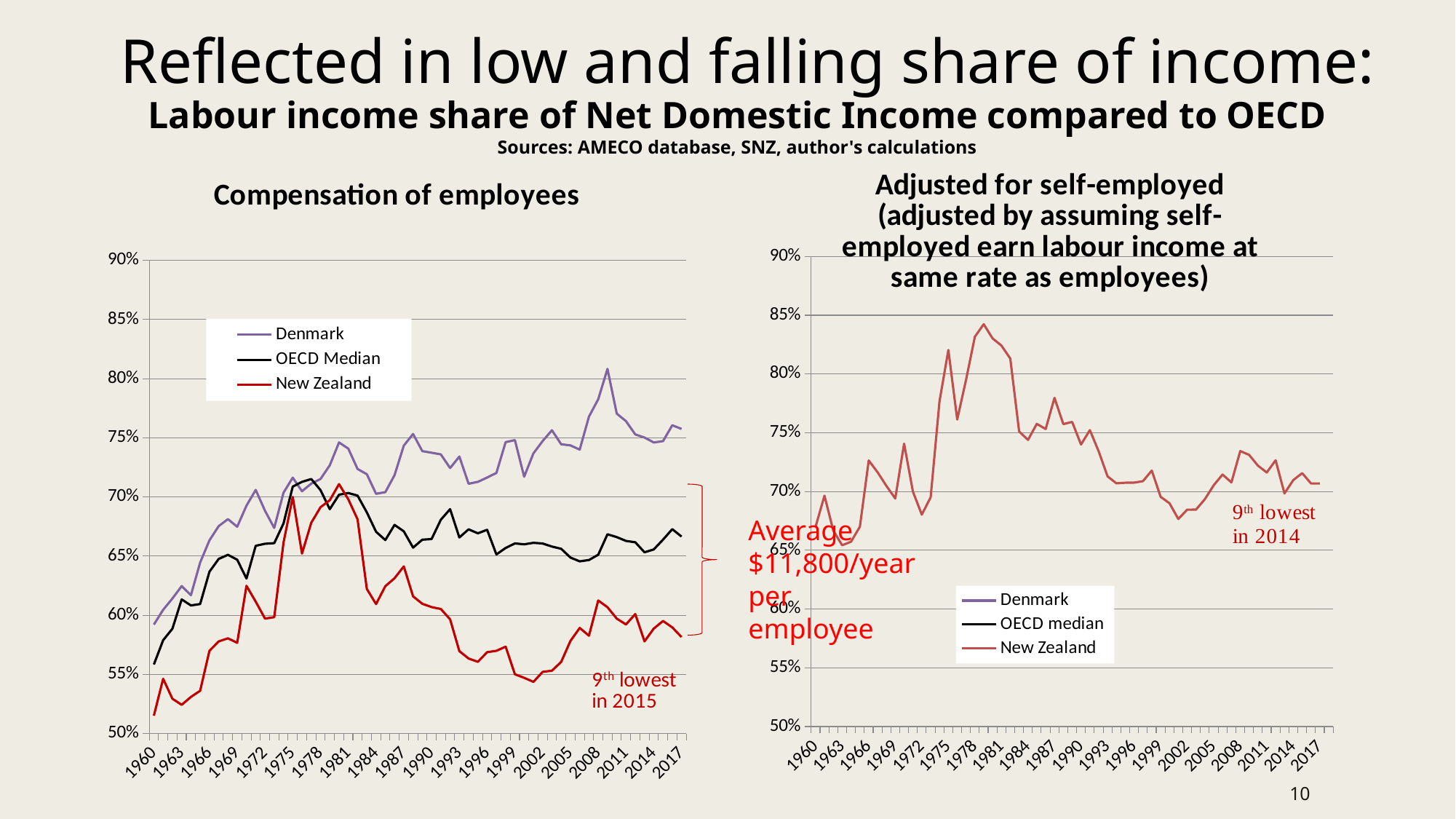
In the 'Compensation of employees' chart, which is larger in 2008: Denmark or OECD Median? Denmark According to the annotation on the 'Compensation of employees' chart, what rank was New Zealand in 2015? 9th lowest In the 'Adjusted for self-employed' chart on the right, is the value for New Zealand in 1960 greater or less than 70%? less In the 'Compensation of employees' chart, which series has the highest value in 2017? Denmark In the 'Adjusted for self-employed' chart on the right, is the peak value of the New Zealand line around 1979 greater or less than 80%? greater In the 'Compensation of employees' chart, is the value for Denmark in 2017 greater or less than 70%? greater How many series does the legend of the 'Compensation of employees' chart list? 3 What kind of chart is the 'Compensation of employees' chart on the left? Line chart In the 'Compensation of employees' chart, which series has the lowest value in 2017? New Zealand In the 'Compensation of employees' chart, does the New Zealand line rise or fall between 1981 and 2002? Fall